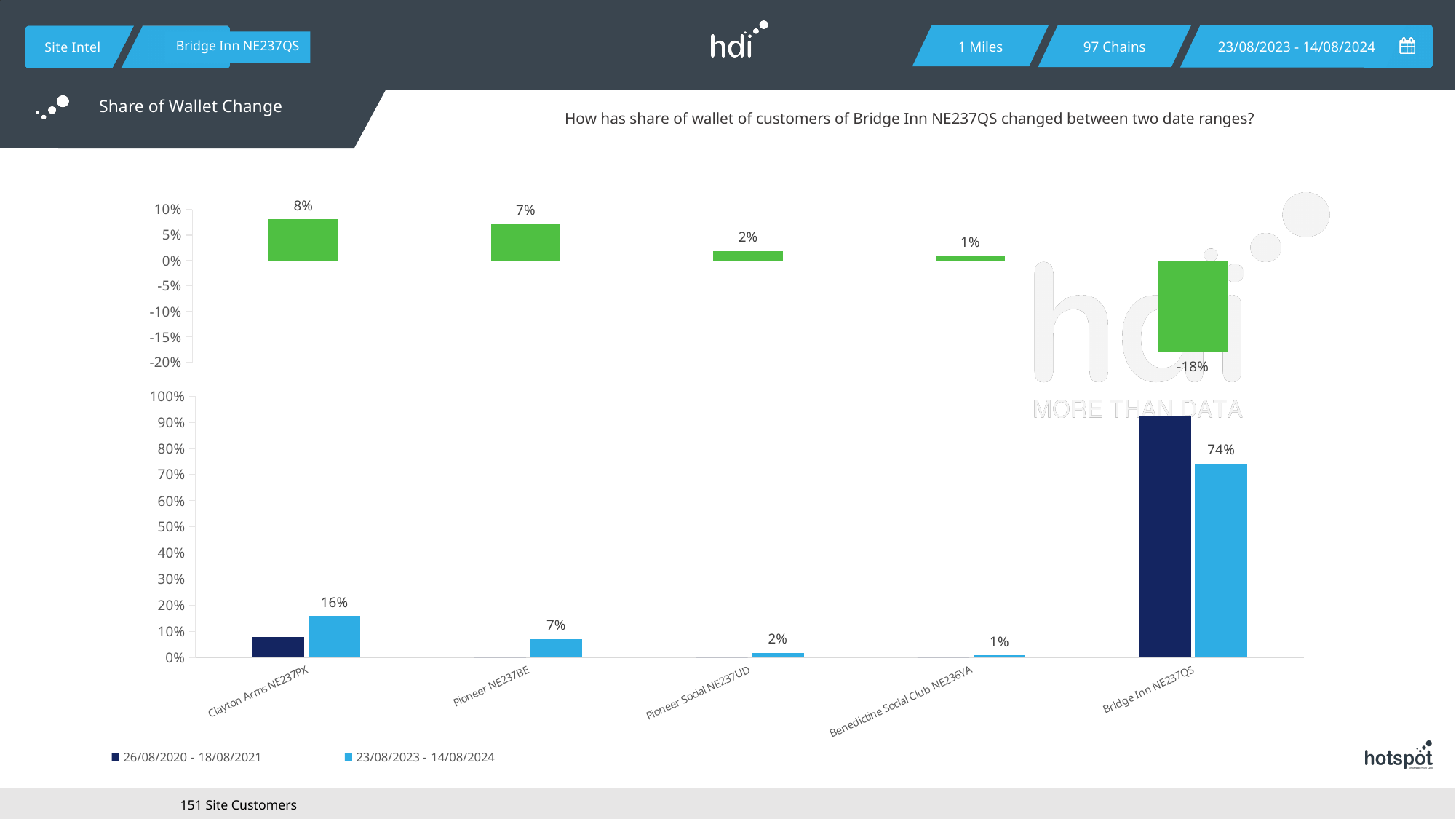
In the bottom chart, is the value for Bridge Inn NE237QS in the 26/08/2020 - 18/08/2021 series greater or less than 80%? greater In the bottom chart, what is the value for Clayton Arms NE237PX in the 23/08/2023 - 14/08/2024 series? 16% In the top chart, which category has the lowest share of wallet change? Bridge Inn NE237QS In the bottom chart, what is the value for Bridge Inn NE237QS in the 23/08/2023 - 14/08/2024 series? 74% How many series does the legend of the bottom chart list? 2 In the top chart, what is the difference between the change for Clayton Arms NE237PX and Pioneer Social NE237UD? 6% How many categories are shown on the x axis of the bottom chart? 5 In the bottom chart, which is larger for Bridge Inn NE237QS: the 26/08/2020 - 18/08/2021 value or the 23/08/2023 - 14/08/2024 value? 26/08/2020 - 18/08/2021 In the top chart, what is the share of wallet change for Bridge Inn NE237QS? -18% What kind of chart is the bottom chart? Bar chart In the top chart, what is the share of wallet change for Clayton Arms NE237PX? 8% In the top chart, which category has the highest share of wallet change? Clayton Arms NE237PX